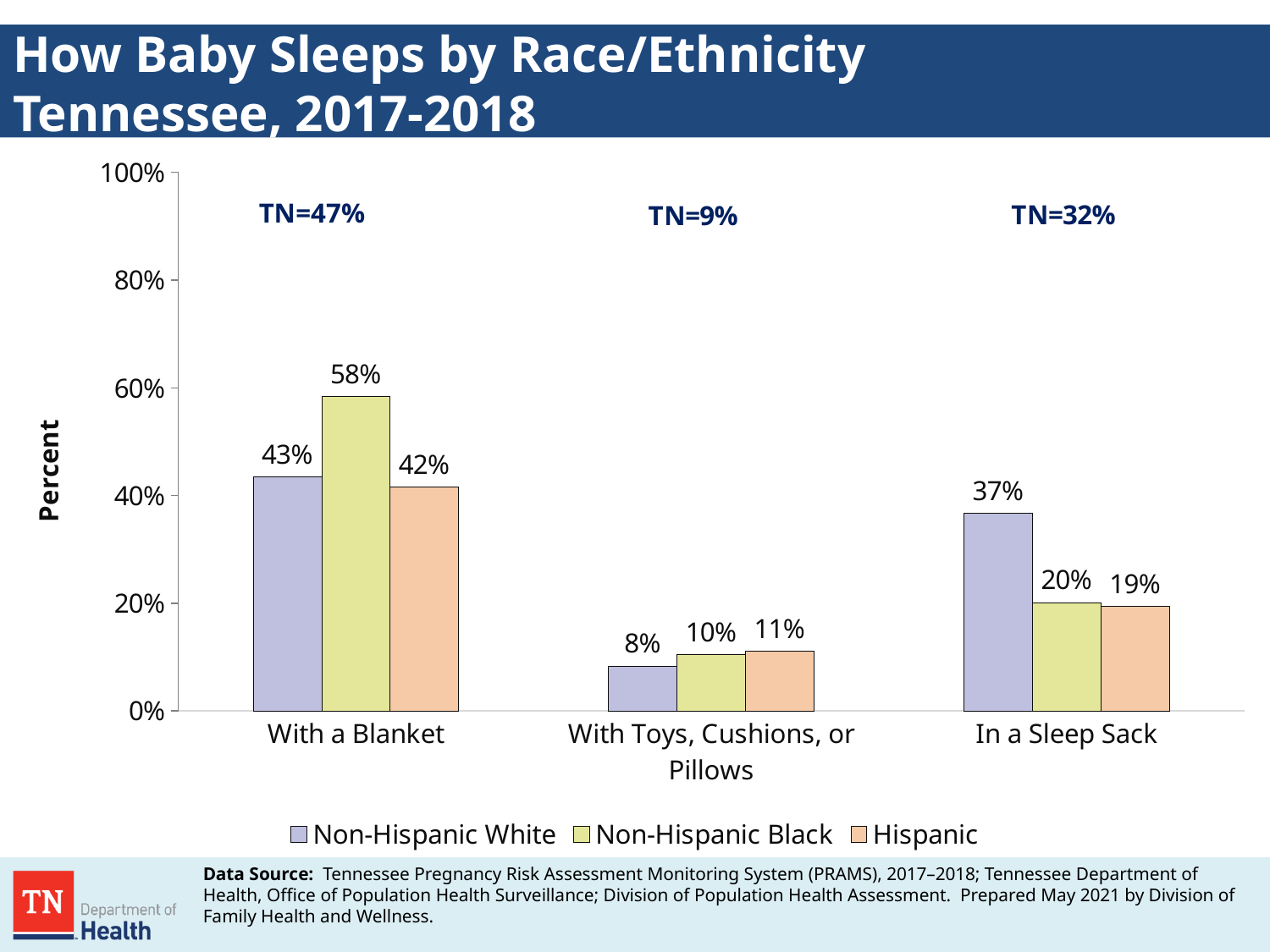
How many sleep-position categories are shown on the x axis? 3 What is the Tennessee overall value (TN=) shown above the 'With Toys, Cushions, or Pillows' group? TN=9% What percentage of Non-Hispanic White babies sleep with toys, cushions, or pillows? 8% Which race/ethnicity group has the highest percentage for 'In a Sleep Sack'? Non-Hispanic White Is the Hispanic value for 'With Toys, Cushions, or Pillows' greater or less than 20%? less Which is larger: the Non-Hispanic White value for 'In a Sleep Sack' or the Non-Hispanic Black value for 'In a Sleep Sack'? Non-Hispanic White What is the value for Hispanic babies sleeping in a sleep sack? 19% Which race/ethnicity group has the lowest percentage for 'With a Blanket'? Hispanic How many series does the legend list? 3 What percentage of Non-Hispanic Black babies sleep with a blanket? 58% What kind of chart is shown on the slide? Bar chart What is the difference between the Non-Hispanic Black and Non-Hispanic White values for 'With a Blanket'? 15%